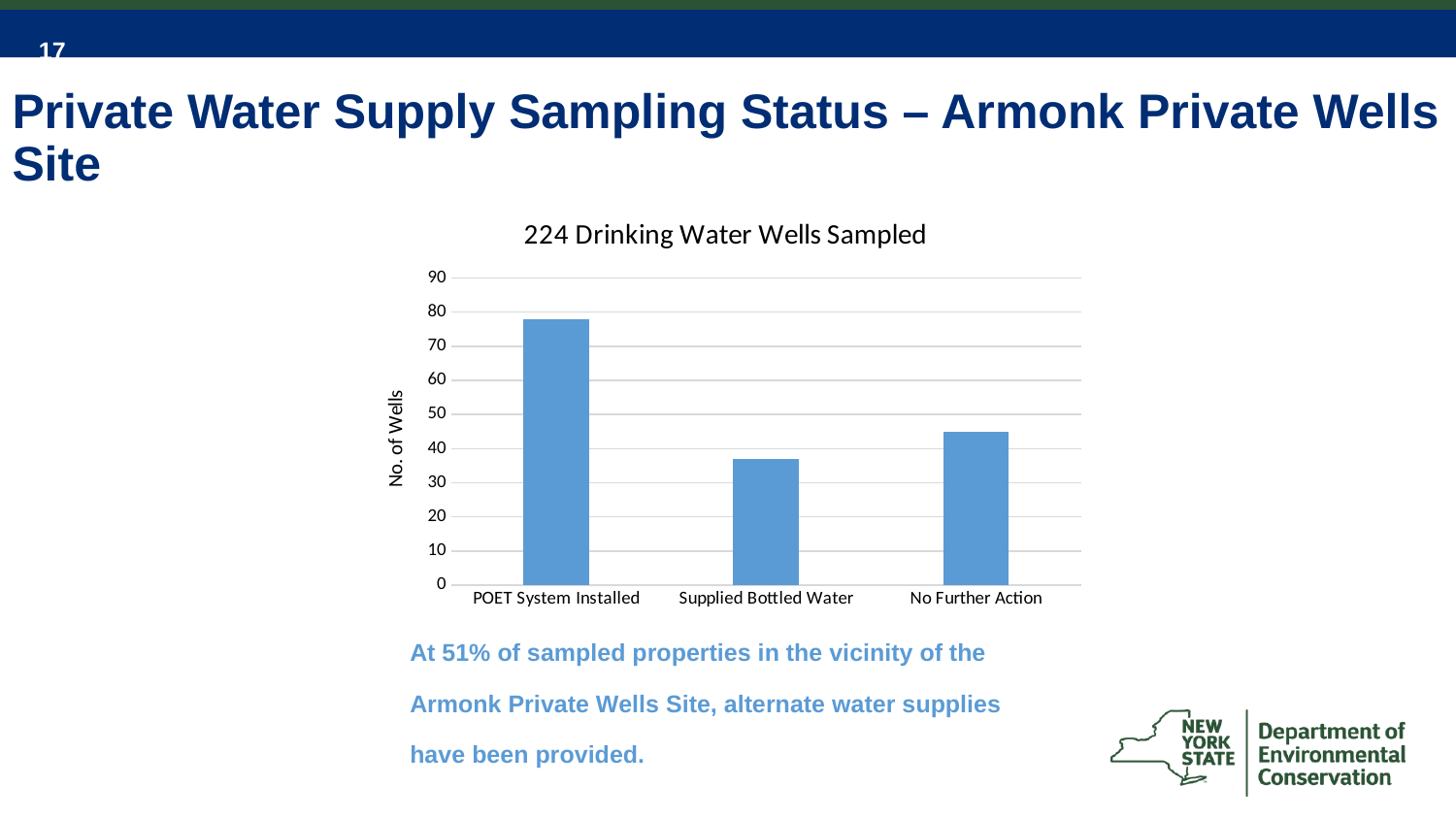
Which is larger, the value for POET System Installed or the value for No Further Action? POET System Installed Which category has the lowest number of wells? Supplied Bottled Water Is the value for POET System Installed greater or less than 70? greater Which is larger, the value for No Further Action or the value for Supplied Bottled Water? No Further Action What is the title of the chart? 224 Drinking Water Wells Sampled How many categories are shown on the x axis of the chart? 3 What is the label of the vertical axis of the chart? No. of Wells Is the value for Supplied Bottled Water greater or less than 50? less Is the value for No Further Action greater or less than 50? less Which category has the highest number of wells? POET System Installed What type of chart is shown on the slide? bar chart